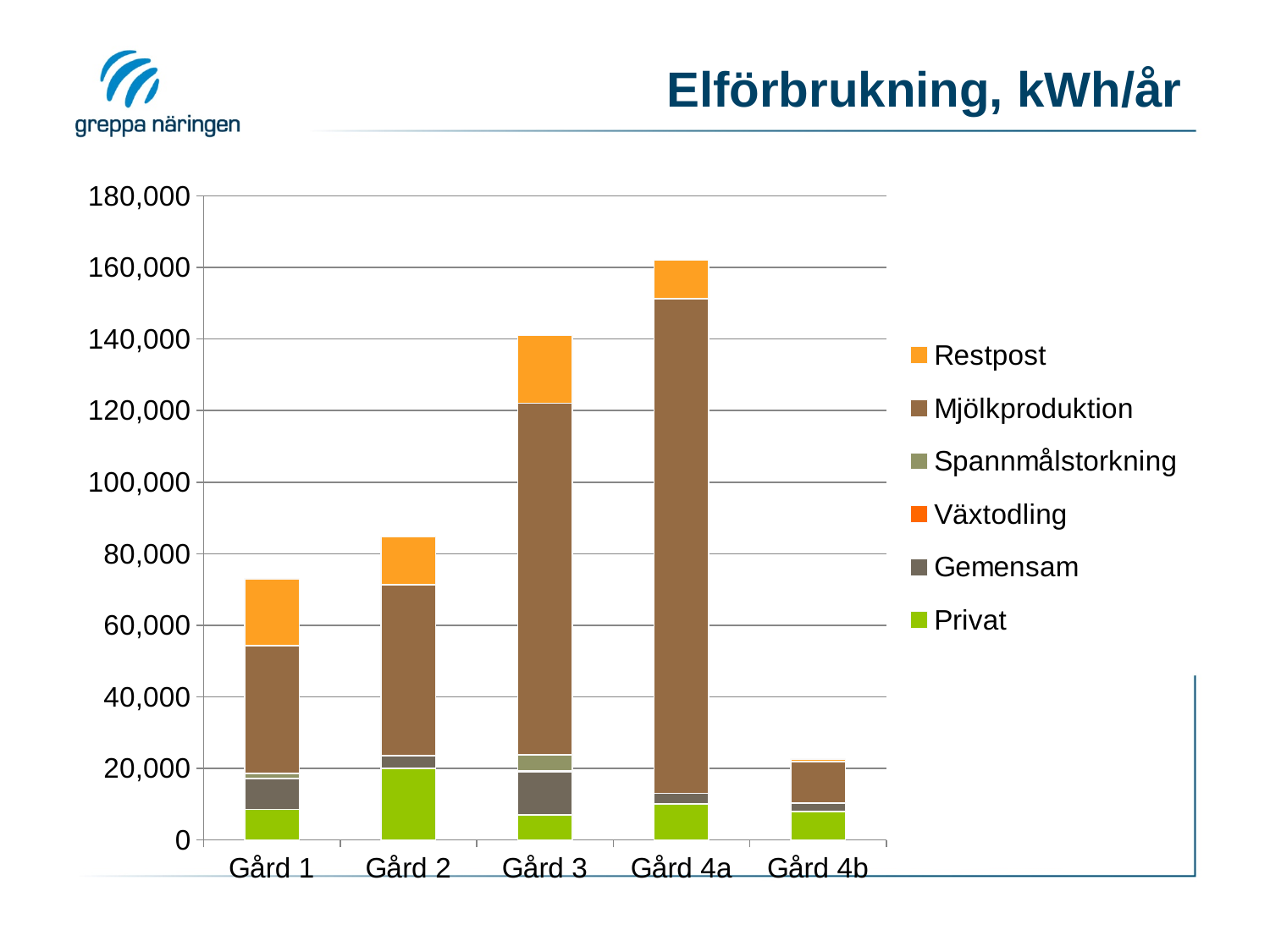
Which farm has the highest total electricity consumption? Gård 4a How many farms (categories) are shown on the x axis? 5 Is the total value for Gård 1 greater or less than 80,000? less Is the total value for Gård 4a greater or less than 140,000? greater What kind of chart is shown on the slide? Stacked bar chart Is the total value for Gård 3 greater or less than 120,000? greater What is the title of the chart? Elförbrukning, kWh/år Which series is shown in orange at the top of the stacked bars? Restpost Which farm has the lowest total electricity consumption? Gård 4b Which has the larger total electricity consumption, Gård 2 or Gård 3? Gård 3 How many series does the legend list? 6